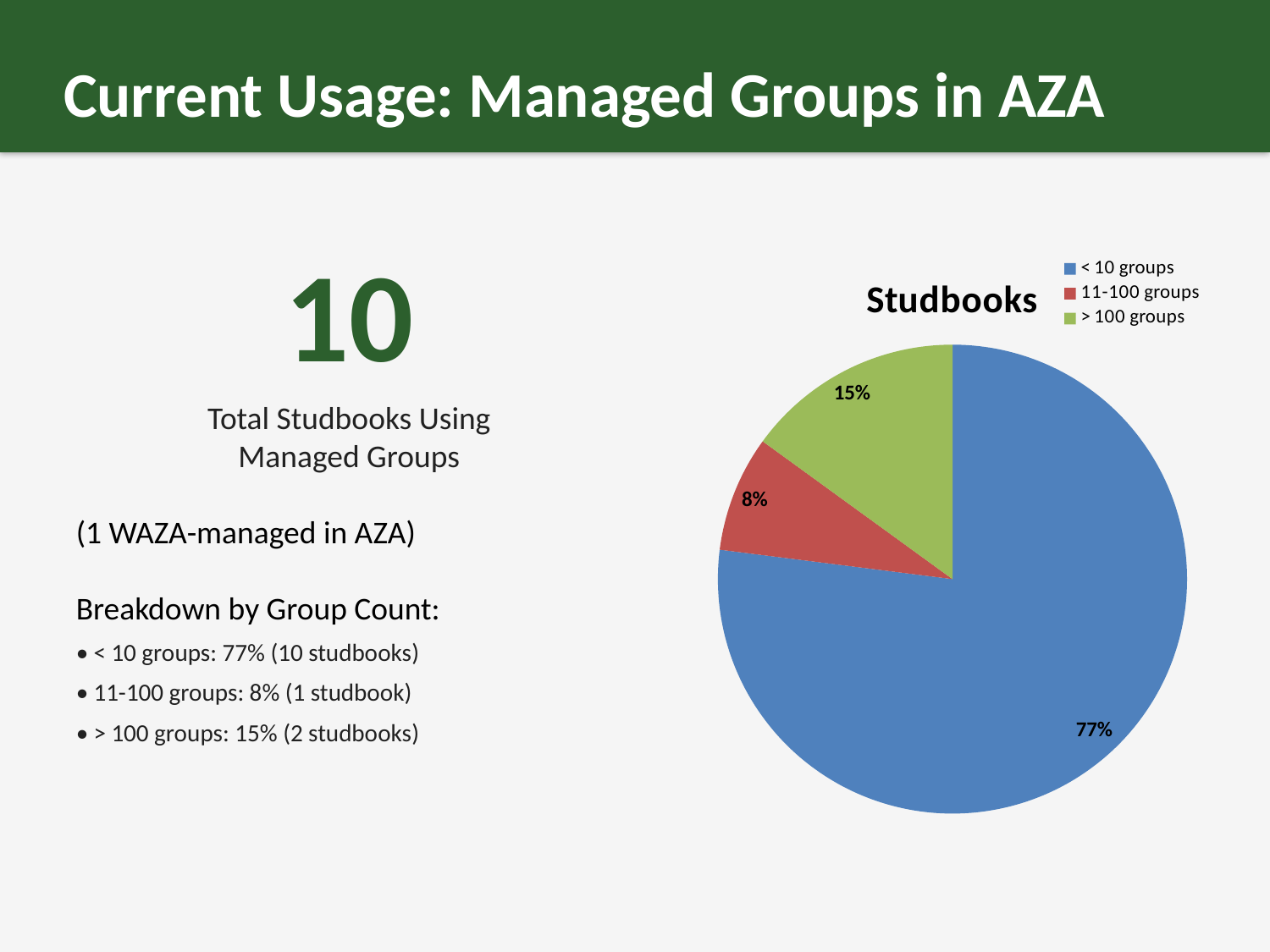
What share of the pie does the '> 100 groups' slice represent? 15% What kind of chart is shown on the slide? pie chart How many slices does the pie chart have? 3 What is the title of the chart? Studbooks What is the difference in percentage points between the '< 10 groups' slice and the '> 100 groups' slice? 62% Which category has the largest slice of the pie? < 10 groups Which slice is larger, '> 100 groups' or '11-100 groups'? > 100 groups Which category has the smallest slice of the pie? 11-100 groups What share of the pie does the '< 10 groups' slice represent? 77% How many entries does the legend list? 3 What share of the pie does the '11-100 groups' slice represent? 8% What colour is the '< 10 groups' slice? blue